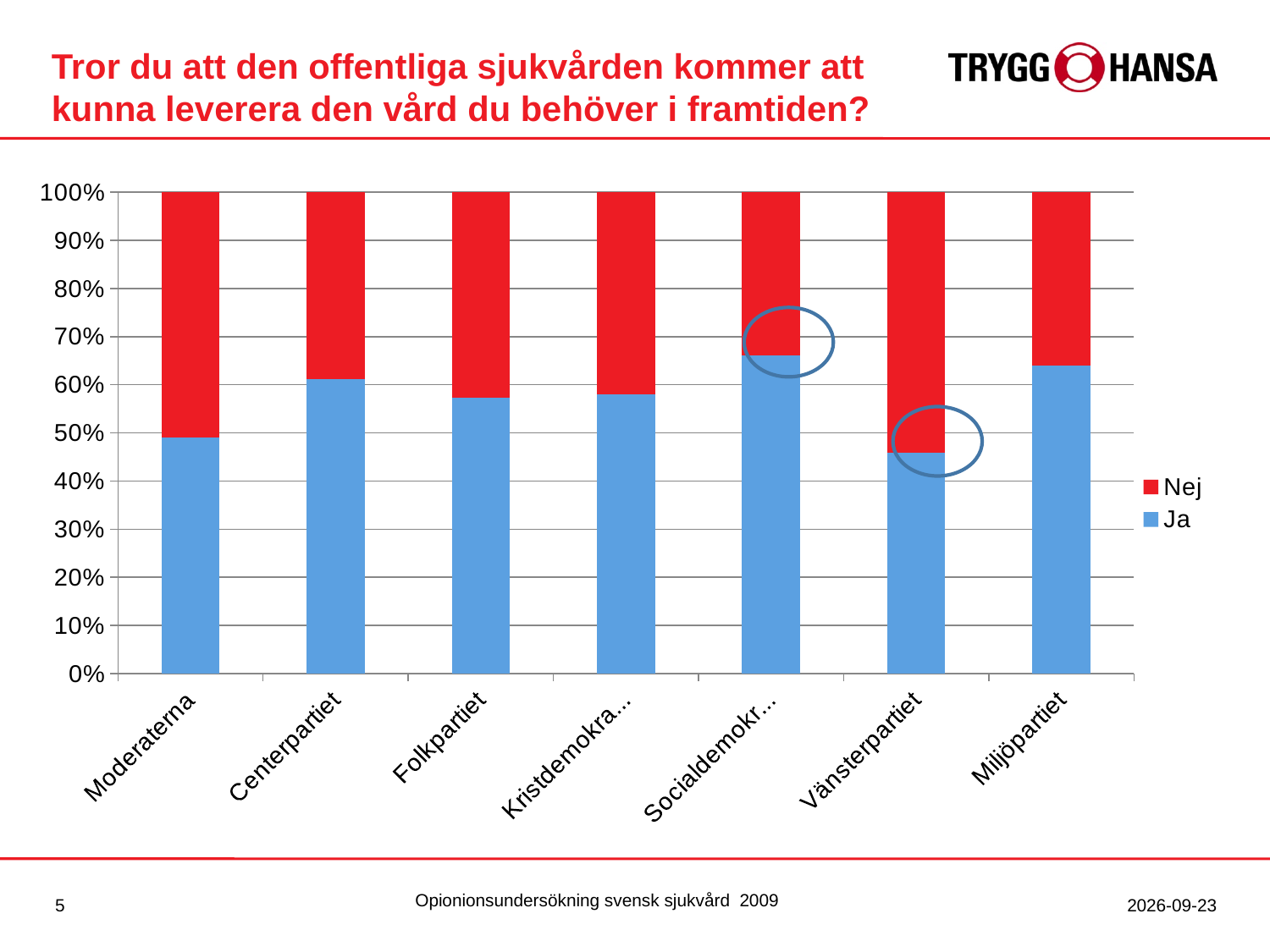
How many parties (categories) are shown on the x axis? 7 Is the 'Ja' value for Socialdemokr... greater or less than 60%? greater What kind of chart is shown on the slide? Stacked bar chart How many series does the legend list? 2 Is the 'Nej' share for Vänsterpartiet greater or less than 50%? greater Is the 'Ja' value for Vänsterpartiet greater or less than 50%? less Which has the larger 'Ja' share, Socialdemokr... or Vänsterpartiet? Socialdemokr... Which has the larger 'Ja' share, Centerpartiet or Moderaterna? Centerpartiet Which series is shown in red in the legend? Nej What is the total of the stacked bar for Miljöpartiet? 100% Which party has the largest 'Nej' share? Vänsterpartiet